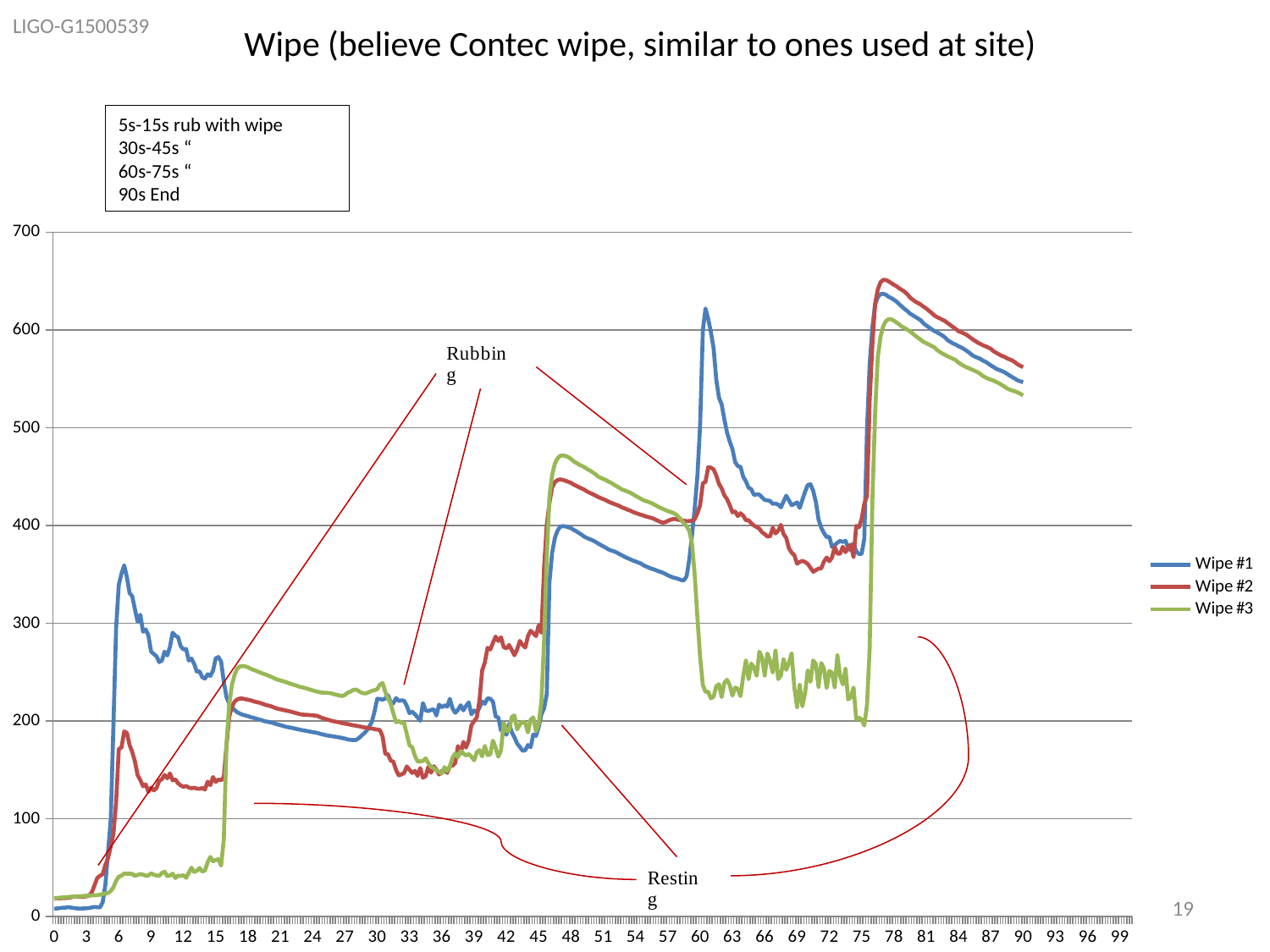
At x = 6, which series has the larger value, Wipe #1 or Wipe #2? Wipe #1 What kind of chart is shown on the slide? line chart Between x = 78 and x = 90, do the values of Wipe #1 rise or fall? fall Is the value of Wipe #3 at x = 66 greater or less than 300? less What are the names of the series in the legend? Wipe #1, Wipe #2, Wipe #3 How many series does the legend list? 3 Is the peak value of Wipe #1 near x = 6 greater or less than 300? greater What is the title of the chart? Wipe (believe Contec wipe, similar to ones used at site) Is the value of Wipe #2 at x = 33 greater or less than 200? less At x = 66, which series has the lowest value? Wipe #3